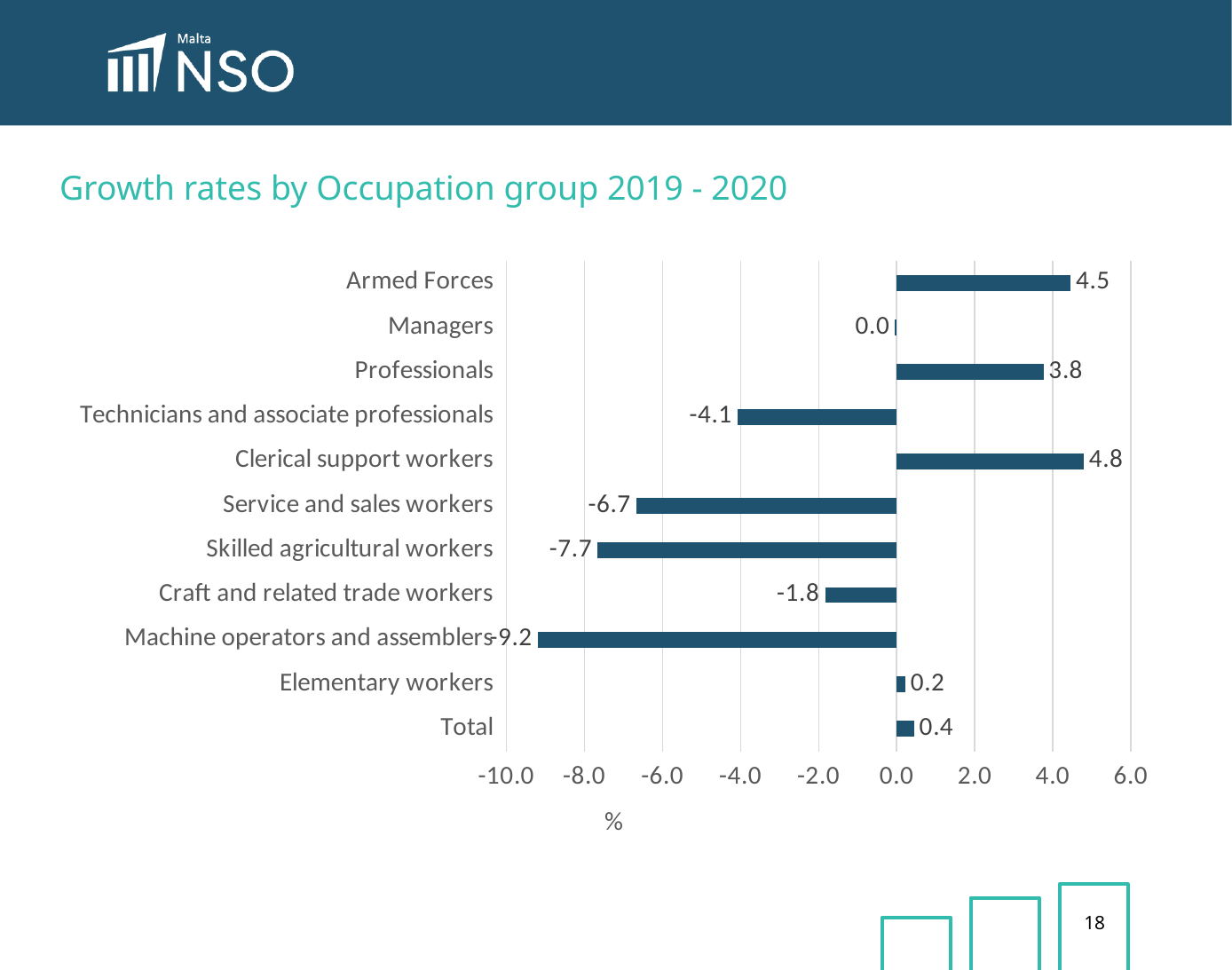
What is the growth rate for the Total category? 0.4 What is the title of the chart? Growth rates by Occupation group 2019 - 2020 What kind of chart is shown on the slide? Bar chart Which occupation group has the highest growth rate? Clerical support workers Which has a larger growth rate, Service and sales workers or Skilled agricultural workers? Service and sales workers What is the growth rate for Machine operators and assemblers? -9.2 What is the growth rate for Managers? 0.0 What is the growth rate for Clerical support workers? 4.8 What is the difference between the growth rates of Armed Forces and Professionals? 0.7 How many categories are shown on the chart? 11 Which occupation group has the lowest growth rate? Machine operators and assemblers What unit is shown on the x axis of the chart? %